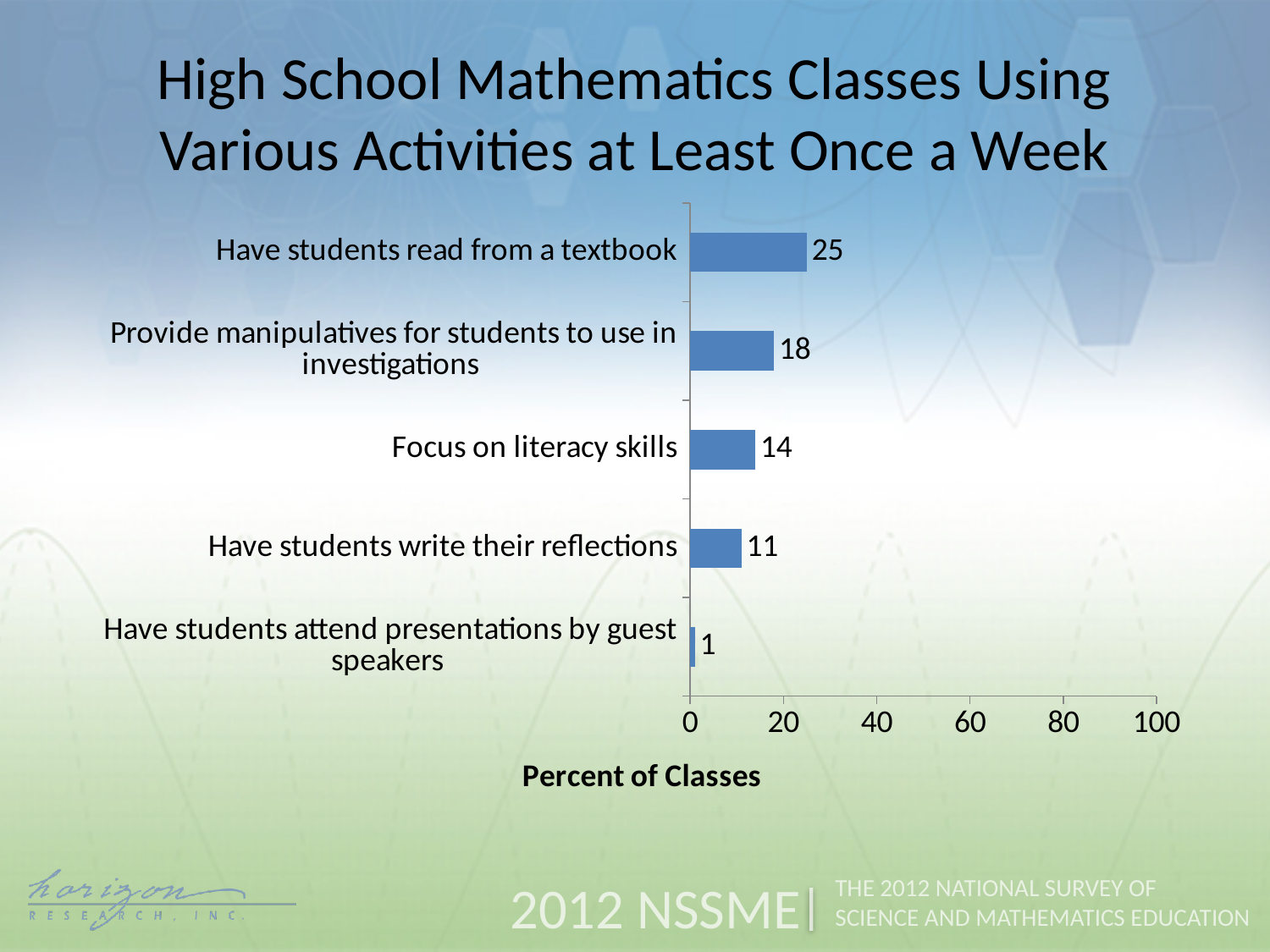
What kind of chart is shown on the slide? bar chart What is the value for 'Have students write their reflections'? 11 How many activities are shown in the chart? 5 Which activity has the lowest percent of classes? Have students attend presentations by guest speakers Which is larger: the value for 'Provide manipulatives for students to use in investigations' or 'Have students write their reflections'? Provide manipulatives for students to use in investigations What is the value for 'Provide manipulatives for students to use in investigations'? 18 What percent of classes have students read from a textbook at least once a week? 25 What is the value for 'Focus on literacy skills'? 14 What is the difference between the values for 'Have students read from a textbook' and 'Focus on literacy skills'? 11 Which activity has the highest percent of classes? Have students read from a textbook What is the label of the horizontal axis? Percent of Classes Is the value for 'Have students read from a textbook' greater or less than 20? greater